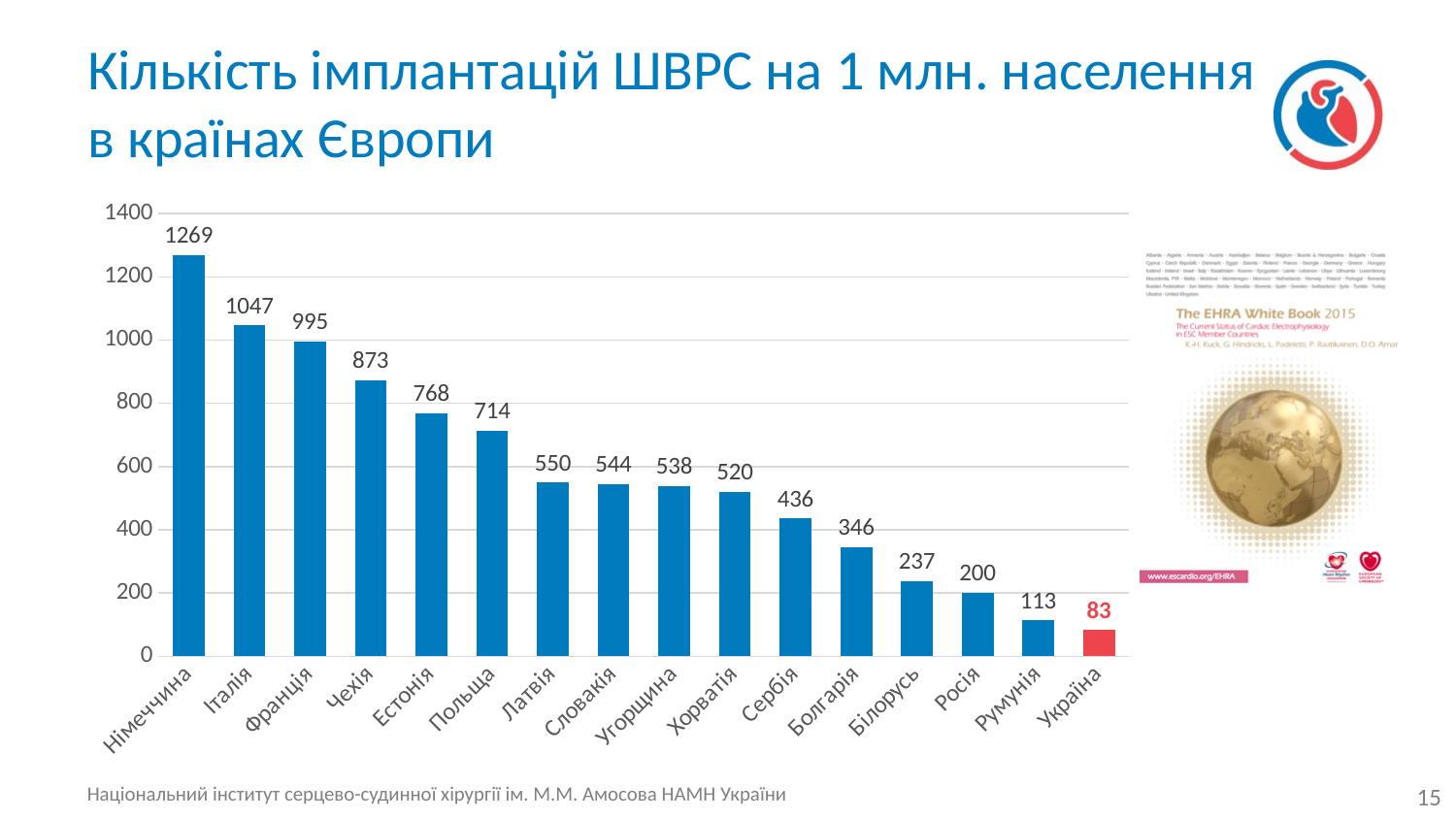
Is the value for Чехія greater or less than 800? greater What is the difference between the values for Румунія and Україна? 30 What kind of chart is shown on the slide? bar chart What is the value for Україна? 83 How many countries are shown on the chart? 16 Which is larger, the value for Латвія or the value for Сербія? Латвія What is the value for Польща? 714 Which country has the lowest value? Україна What is the difference between the values for Італія and Франція? 52 Which bar is coloured differently (red) from the others? Україна Which country has the highest value? Німеччина What is the value for Німеччина? 1269